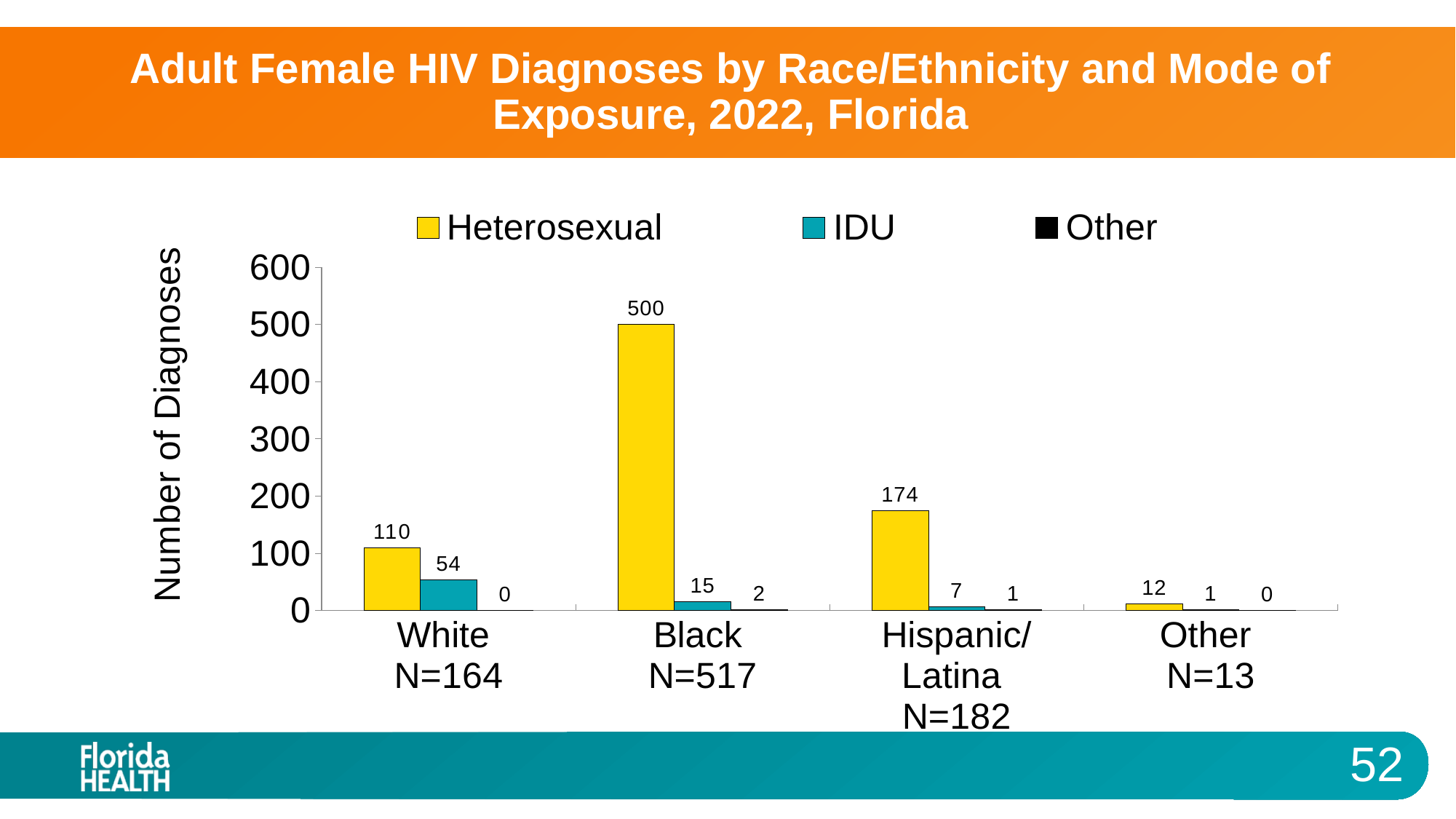
Which race/ethnicity group has the lowest number of IDU diagnoses? Other What is the number of Other mode of exposure diagnoses for Hispanic/Latina adult females? 1 What is the number of Heterosexual diagnoses for Black adult females? 500 What is the difference between Heterosexual diagnoses for Black and Hispanic/Latina adult females? 326 What is the total N shown for the Hispanic/Latina group? N=182 What is the number of Heterosexual diagnoses for the Other race/ethnicity group? 12 What is the number of IDU diagnoses for White adult females? 54 What kind of chart is shown on the slide? Bar chart How many series does the legend list? 3 Which race/ethnicity group has the highest number of Heterosexual diagnoses? Black Which is larger: IDU diagnoses for White or IDU diagnoses for Black adult females? White How many race/ethnicity categories are shown on the x axis? 4